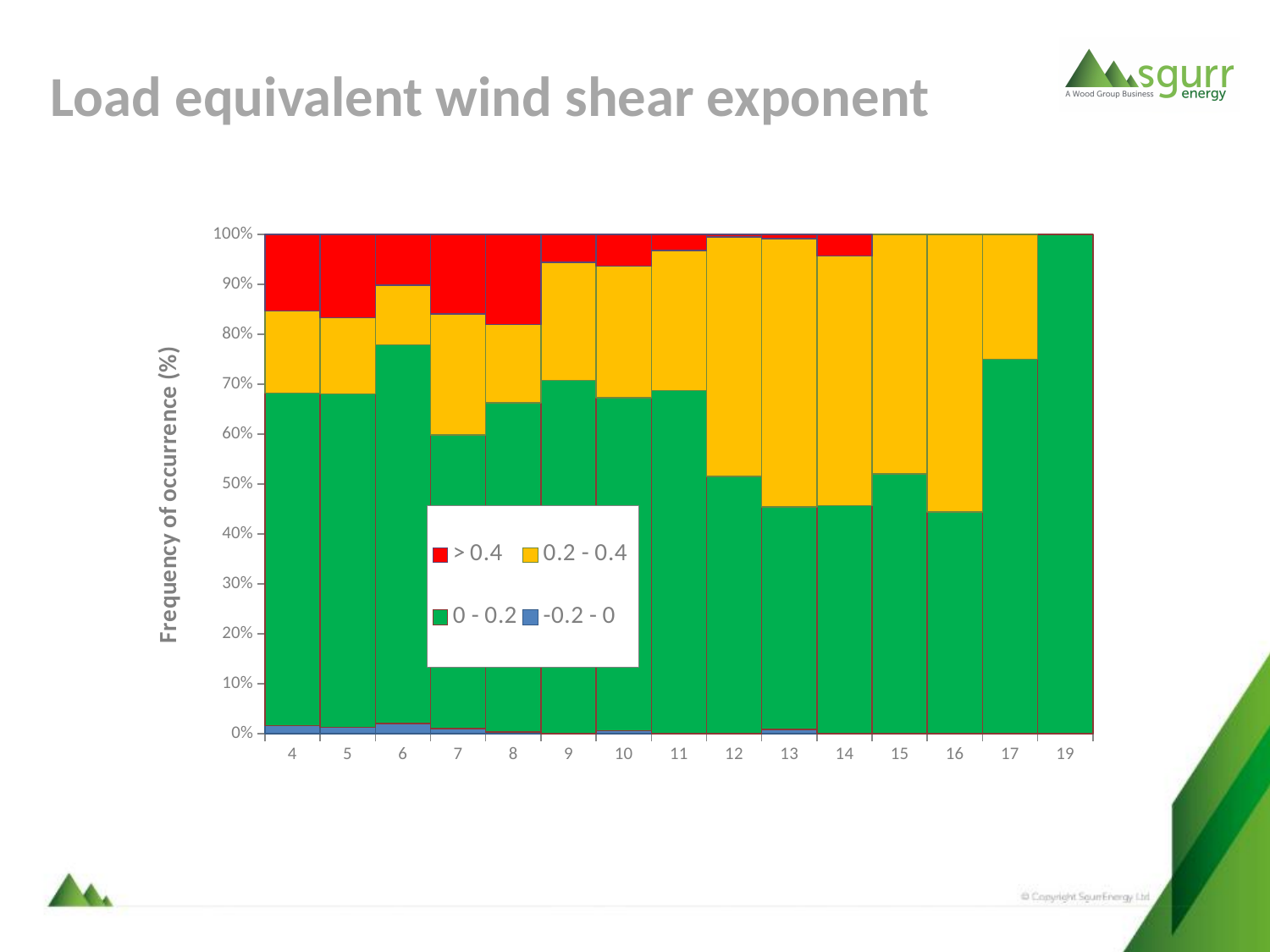
Is the 0 - 0.2 share for category 6 greater or less than 70%? greater Is the 0 - 0.2 share for category 16 greater or less than 50%? less What kind of chart is shown on the slide? Stacked bar chart Which category has the largest 0 - 0.2 share? 19 How many categories are shown along the x axis? 15 How many series does the legend list? 4 What is the title of the y axis? Frequency of occurrence (%) Which series is shown in red in the legend? > 0.4 Is the 0 - 0.2 share for category 19 greater or less than 90%? greater Which has the larger 0 - 0.2 share, category 6 or category 16? 6 What is the total of the stacked bar for category 12? 100%